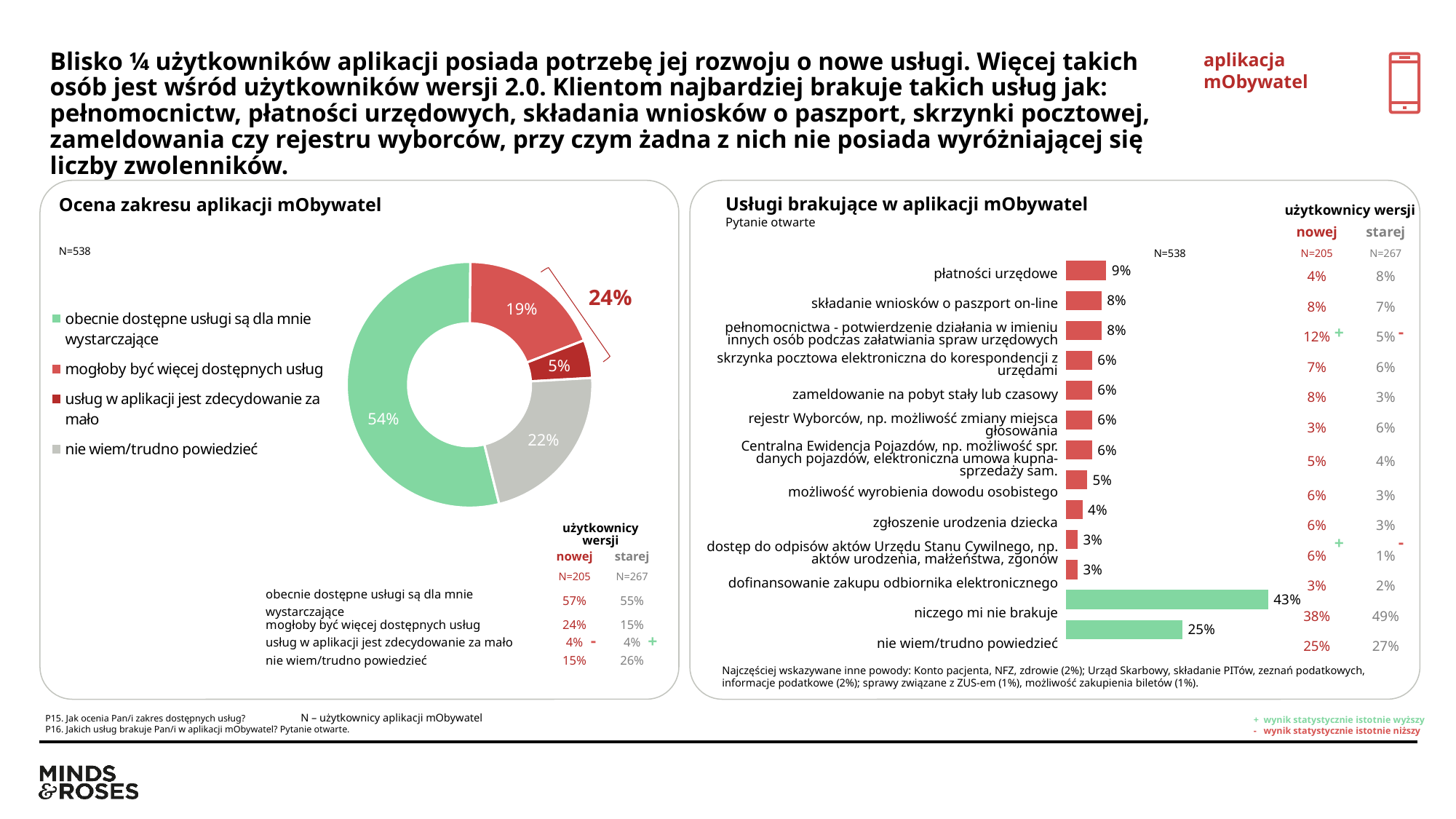
In the 'Ocena zakresu aplikacji mObywatel' chart, which category has the smallest share? usług w aplikacji jest zdecydowanie za mało In the 'Usługi brakujące w aplikacji mObywatel' chart, which is larger: 'zgłoszenie urodzenia dziecka' or 'możliwość wyrobienia dowodu osobistego'? możliwość wyrobienia dowodu osobistego What type of chart is 'Ocena zakresu aplikacji mObywatel'? Donut (pie) chart In the 'Ocena zakresu aplikacji mObywatel' chart, what is the combined share of 'mogłoby być więcej dostępnych usług' and 'usług w aplikacji jest zdecydowanie za mało'? 24% How many categories does the legend of the 'Ocena zakresu aplikacji mObywatel' chart list? 4 How many categories are plotted in the 'Usługi brakujące w aplikacji mObywatel' chart? 13 In the 'Usługi brakujące w aplikacji mObywatel' chart, which category has the highest value? niczego mi nie brakuje In the 'Usługi brakujące w aplikacji mObywatel' chart, what is the difference between 'niczego mi nie brakuje' and 'nie wiem/trudno powiedzieć'? 18% In the 'Usługi brakujące w aplikacji mObywatel' chart, what is the value for 'płatności urzędowe'? 9% In the 'Ocena zakresu aplikacji mObywatel' chart, what share of respondents say the currently available services are sufficient ('obecnie dostępne usługi są dla mnie wystarczające')? 54% What type of chart is 'Usługi brakujące w aplikacji mObywatel'? Bar chart In the 'Ocena zakresu aplikacji mObywatel' chart, what is the value for 'nie wiem/trudno powiedzieć'? 22%